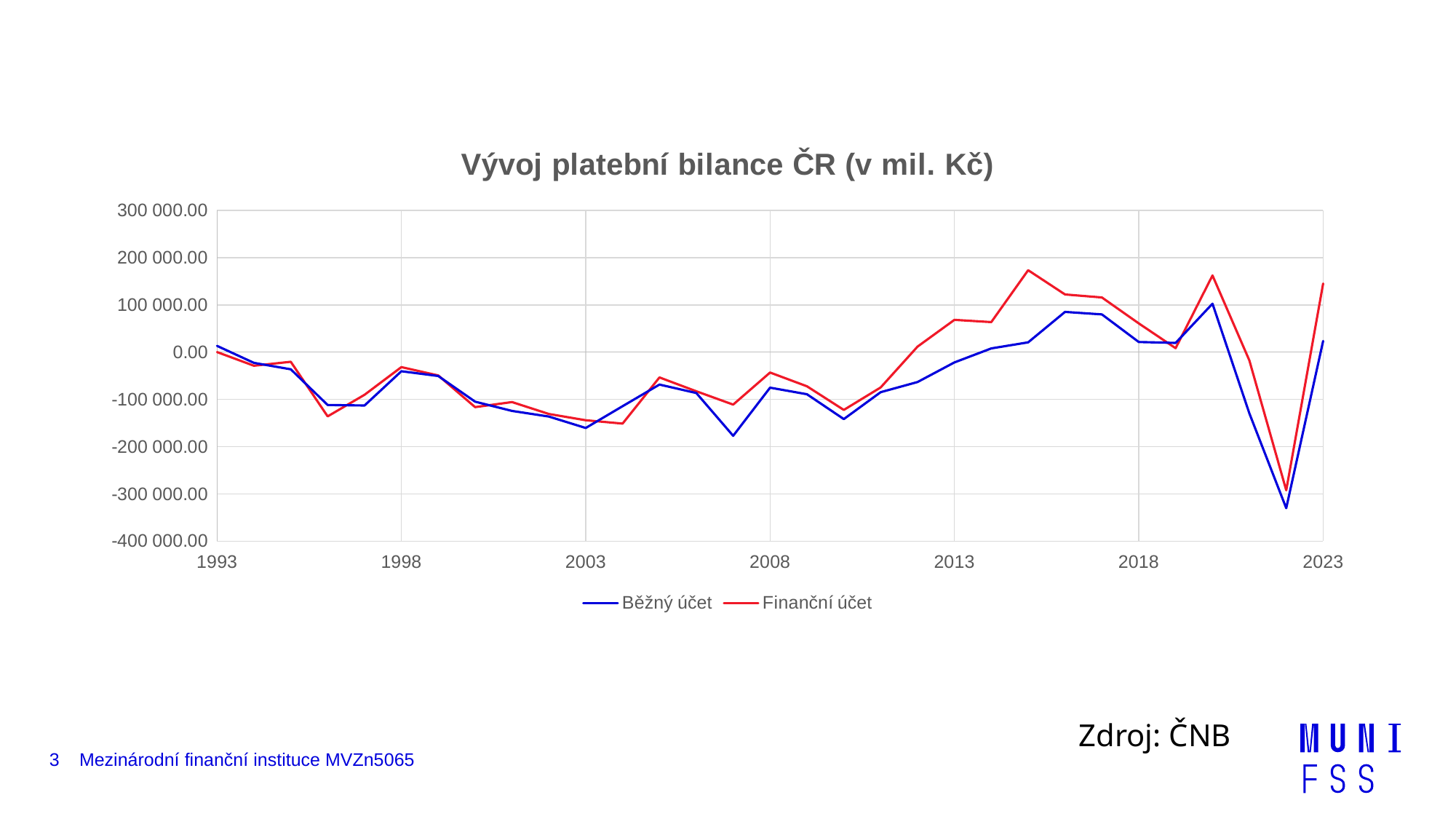
What is the title of the chart? Vývoj platební bilance ČR (v mil. Kč) Is the value for Finanční účet in 2015 greater or less than 100 000.00? greater Which series is drawn in red? Finanční účet Is the value for Běžný účet in 2022 greater or less than -300 000.00? less What kind of chart is shown on the slide? line chart In which year does Běžný účet reach its lowest value? 2022 Is the value for Běžný účet in 2007 greater or less than -100 000.00? less In 2022, which series has the lower value, Běžný účet or Finanční účet? Běžný účet How many series does the legend list? 2 Between 2020 and 2022, does the Běžný účet line rise or fall? fall In 2015, which series has the higher value, Běžný účet or Finanční účet? Finanční účet